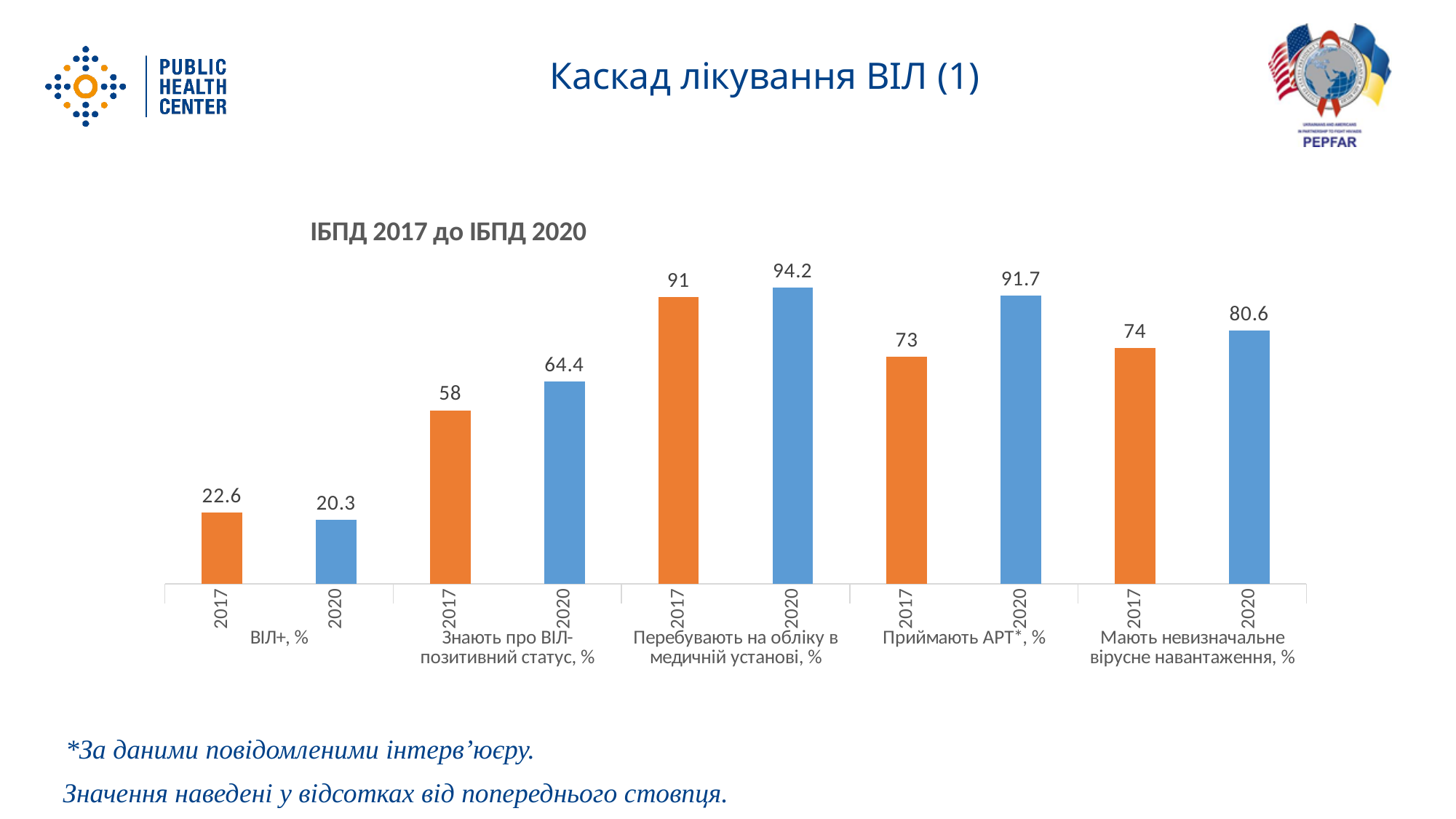
What is the difference between the 2020 and 2017 values for "Знають про ВІЛ-позитивний статус, %"? 6.4 What is the 2017 value for "ВІЛ+, %"? 22.6 For "ВІЛ+, %", which is larger: the 2017 value or the 2020 value? 2017 What is the title of the chart? ІБПД 2017 до ІБПД 2020 What kind of chart is shown on the slide? Bar chart How many categories are shown on the x axis of the chart? 5 What is the 2020 value for "Приймають АРТ*, %"? 91.7 What is the 2020 value for "Знають про ВІЛ-позитивний статус, %"? 64.4 Which bar has the lowest value on the chart? 2020, ВІЛ+, % What is the 2017 value for "Мають невизначальне вірусне навантаження, %"? 74 What is the difference between the 2020 and 2017 values for "Приймають АРТ*, %"? 18.7 Which bar has the highest value on the chart? 2020, Перебувають на обліку в медичній установі, %